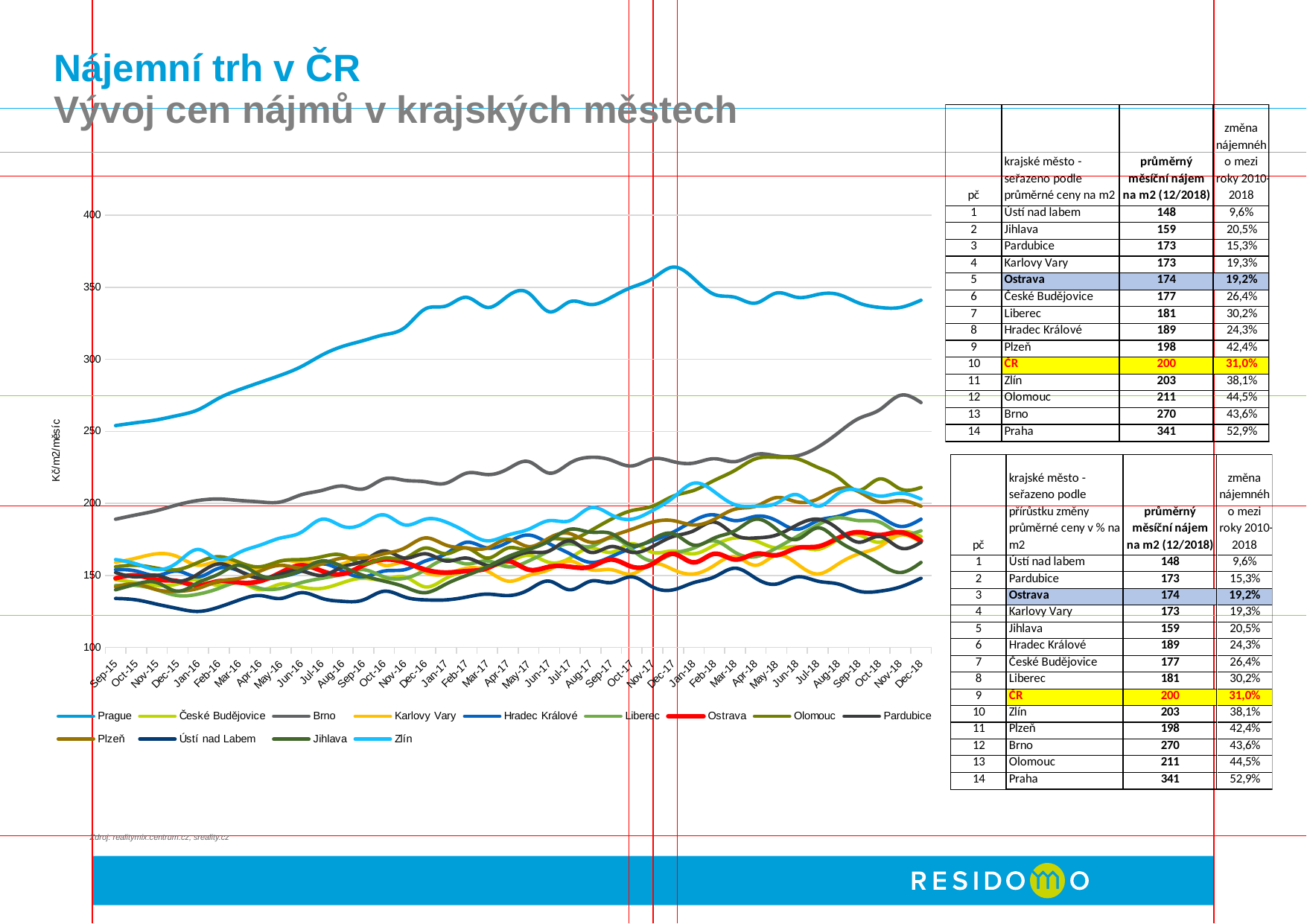
How many monthly points are on the x axis from Sep-15 to Dec-18? 40 Is the value for Brno in Dec-18 greater or less than 250? greater Which is larger in Dec-18, the value for Prague or the value for Brno? Prague Is the value for Prague in Dec-18 greater or less than 300? greater Does the Prague line rise or fall from Sep-15 to Dec-18? rise Which city has the highest rent line throughout the chart? Prague What kind of chart is shown on the slide? line chart How many series does the chart legend list? 13 Which series is drawn in red on the chart? Ostrava Which city has the lowest rent line at the start of the chart (Sep-15)? Ústí nad Labem Is the value for Prague in Sep-15 greater or less than 300? less